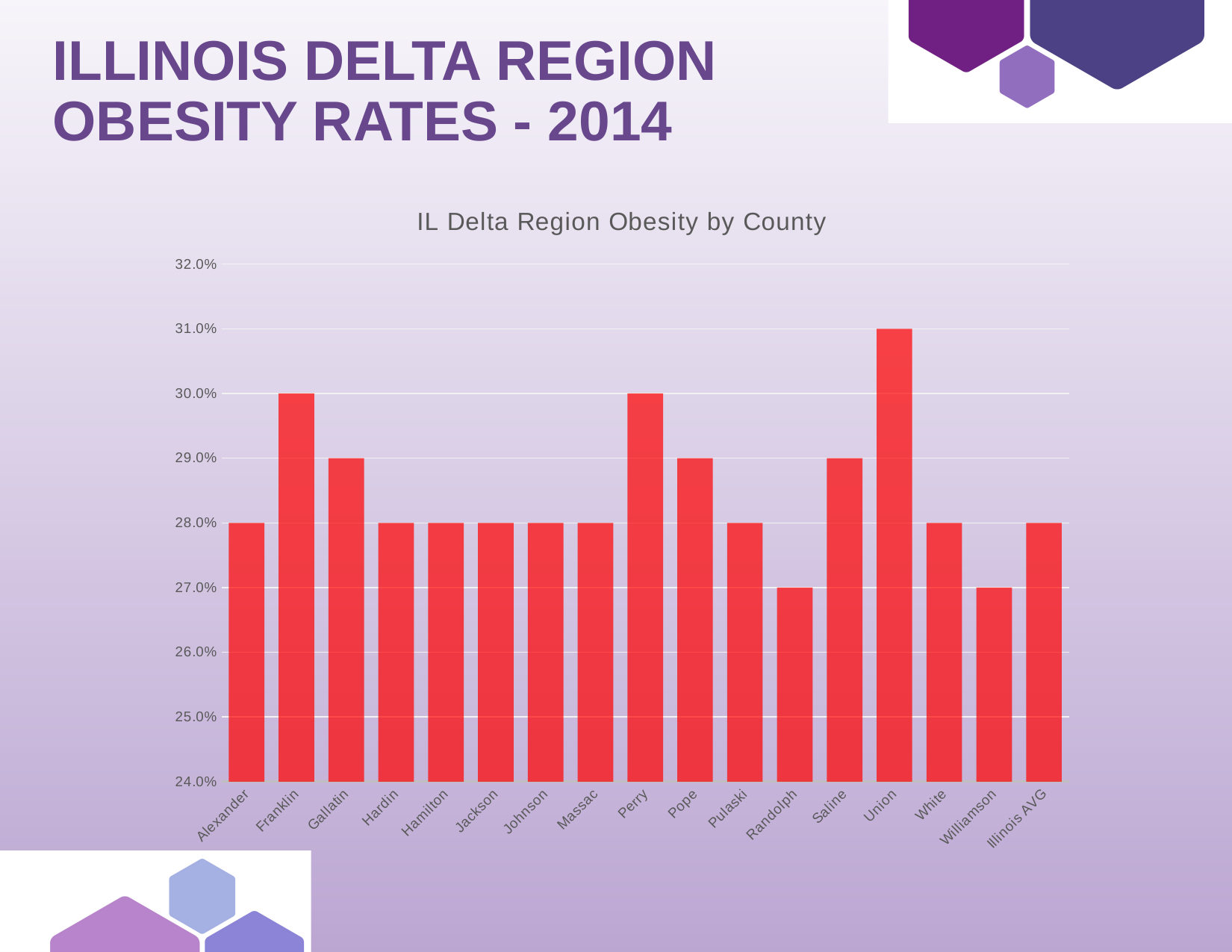
How many categories are plotted on the x axis? 17 Is the value for Perry greater or less than 29.0%? greater What is the difference between the obesity rates of Union and Randolph? 4.0 percentage points Is the value for Williamson greater or less than 28.0%? less Which is larger, the obesity rate for Franklin or for Gallatin? Franklin What type of chart is shown on the slide? Bar chart Which county has the highest obesity rate in the chart? Union What is the obesity rate for Randolph? 27.0% What is the obesity rate for Franklin? 30.0% What is the title of the chart? IL Delta Region Obesity by County What is the value shown for Illinois AVG? 28.0% What is the obesity rate for Union? 31.0%